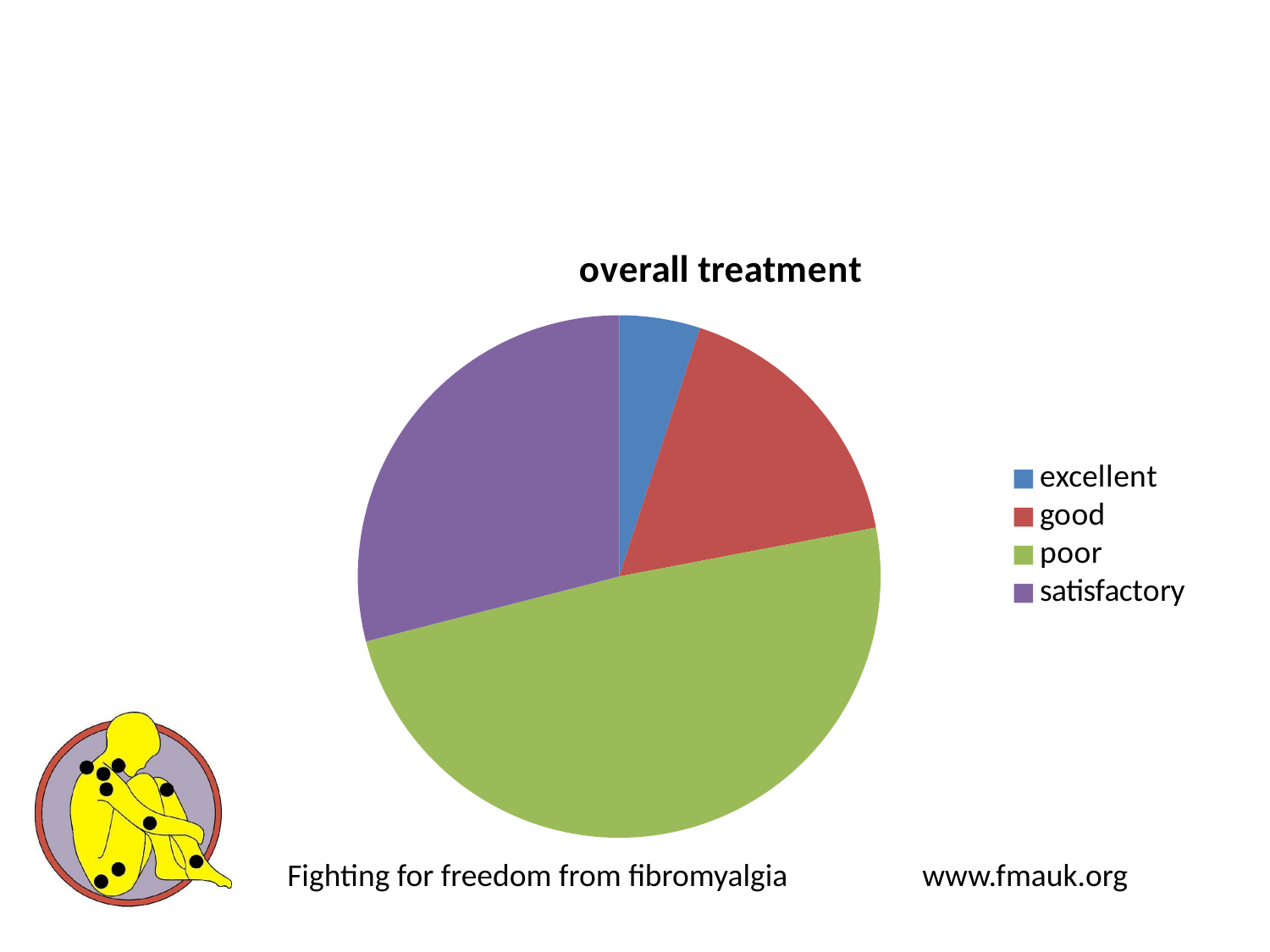
Which category has the smallest slice of the pie? excellent Which category has the largest slice of the pie? poor What is the title of the chart? overall treatment Which slice is larger, good or excellent? good What kind of chart is shown on the slide? pie chart Which slice is larger, poor or satisfactory? poor Which colour represents the 'poor' category in the pie chart? green How many categories does the pie chart have? 4 Which slice is larger, satisfactory or good? satisfactory How many entries does the legend list? 4